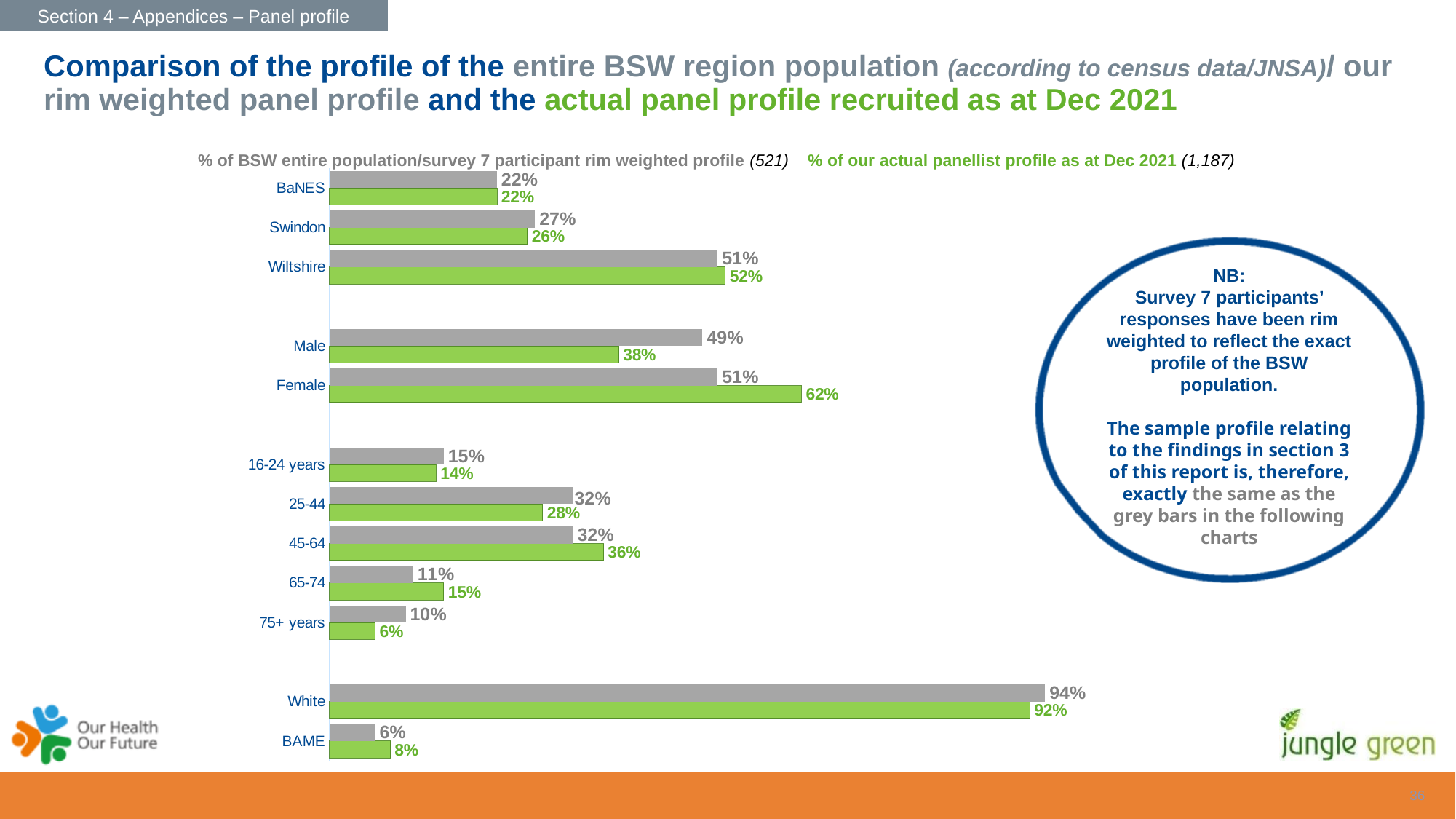
Which category has the lowest value in the actual panellist profile series? 75+ years What is the difference between the actual panellist profile and the rim weighted profile values for Female? 11% What is the value for Male in the '% of BSW entire population/survey 7 participant rim weighted profile' series? 49% What colour are the bars for the actual panellist profile as at Dec 2021 series? green What is the value for Female in the '% of our actual panellist profile as at Dec 2021' series? 62% For 25-44, which series has the larger value: the rim weighted profile or the actual panellist profile? rim weighted profile What is the value for 75+ years in the actual panellist profile series? 6% What kind of chart is shown on the slide? bar chart How many series does the chart show? 2 What is the difference between the rim weighted profile and the actual panellist profile values for Male? 11% For 45-64, which series has the larger value: the rim weighted profile or the actual panellist profile? actual panellist profile Which category has the highest value in the rim weighted profile series? White